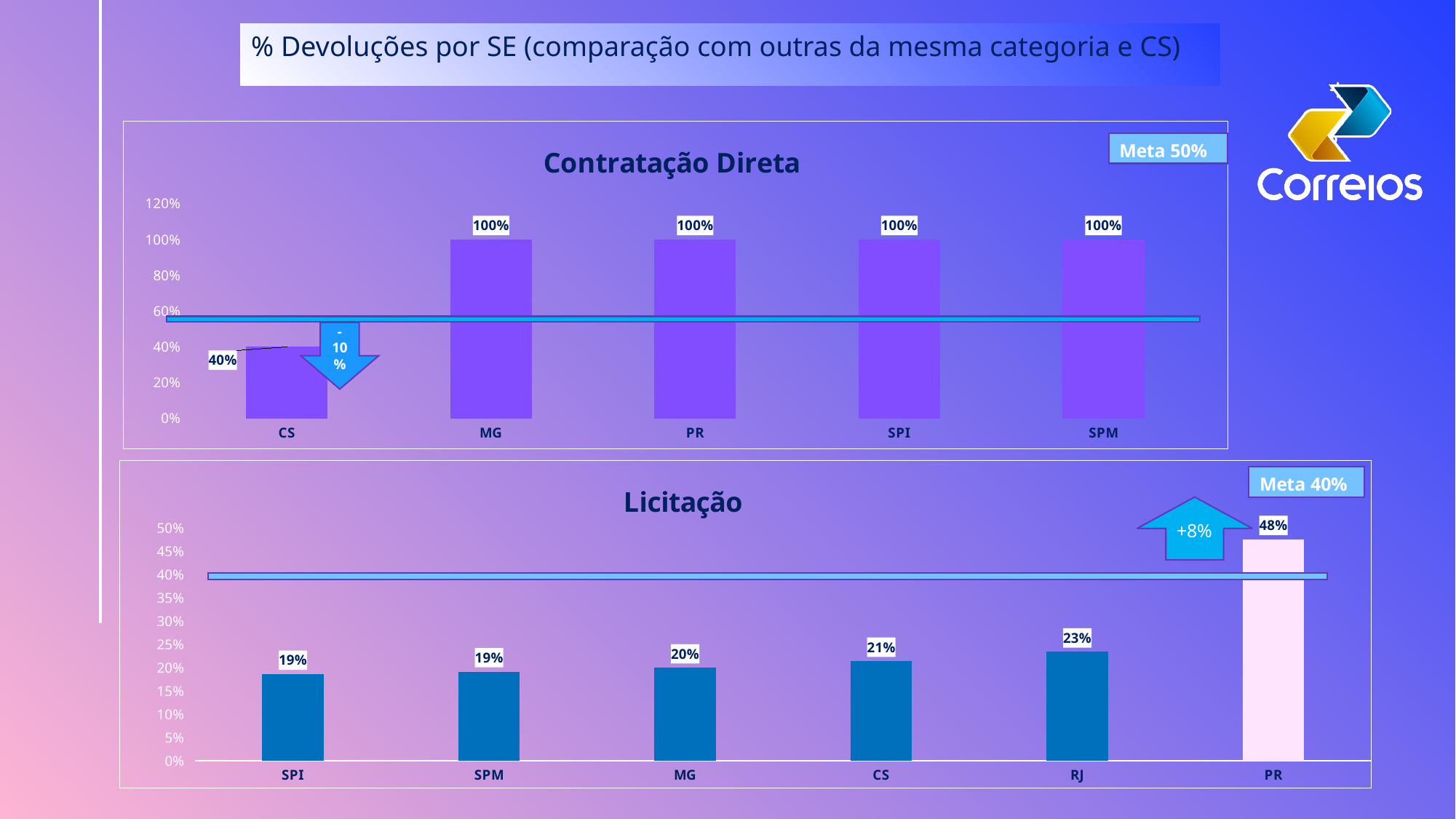
In the 'Licitação' chart, how many categories are shown on the x axis? 6 In the 'Licitação' chart, which is larger, the value for RJ or the value for MG? RJ What kind of chart is the 'Licitação' chart? Bar chart In the 'Licitação' chart, what is the value for PR? 48% In the 'Licitação' chart, what is the difference between the values for PR and CS? 27% In the 'Licitação' chart, what is the value for RJ? 23% In the 'Contratação Direta' chart, which category has the lowest value? CS In the 'Contratação Direta' chart, what is the value for CS? 40% In the 'Licitação' chart, which category has the highest value? PR In the 'Contratação Direta' chart, what is the value for MG? 100% In the 'Contratação Direta' chart, what is the difference between the values for SPM and CS? 60% In the 'Contratação Direta' chart, how many categories are shown on the x axis? 5